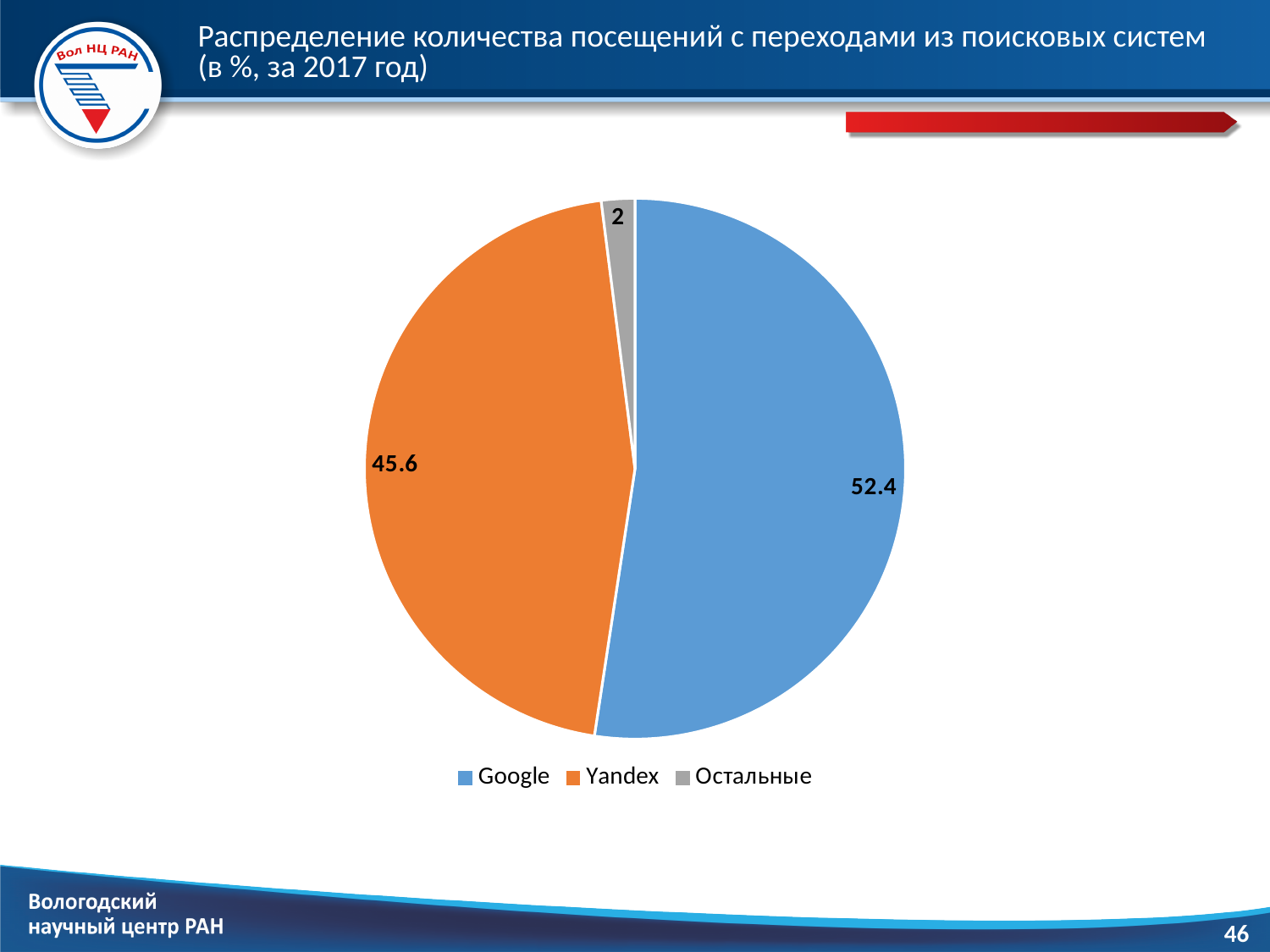
What is the value for Yandex? 45.6 How many entries does the legend list? 3 Which is larger, the value for Yandex or the value for Остальные? Yandex What is the difference between the values for Google and Yandex? 6.8 What is the difference between the values for Yandex and Остальные? 43.6 Which category has the largest share of the pie? Google What type of chart is shown on the slide? pie chart What is the value for Остальные? 2 Which category has the smallest share of the pie? Остальные What colour is the Yandex slice? orange What is the value for Google? 52.4 How many slices does the pie chart have? 3